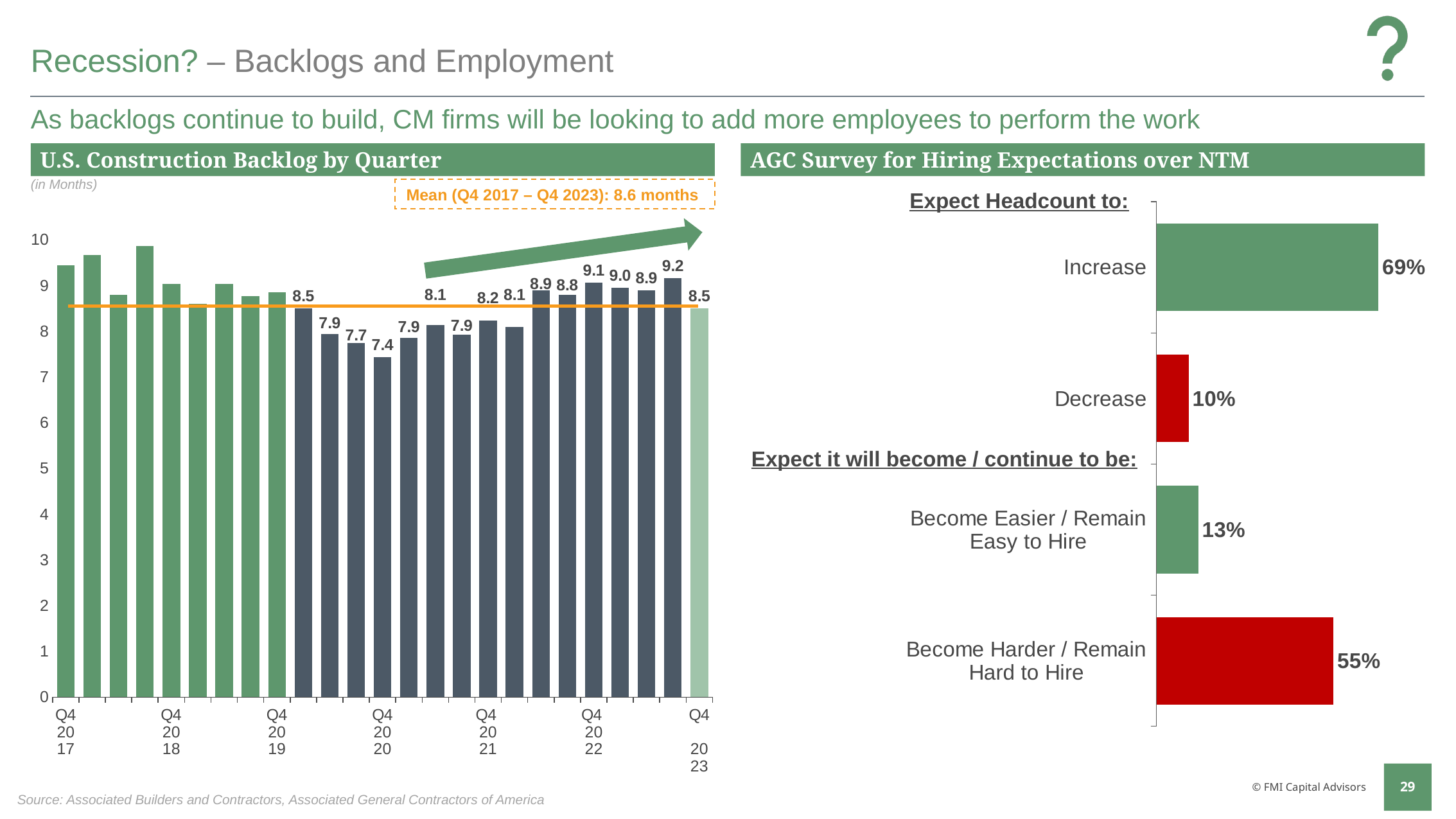
In the U.S. Construction Backlog by Quarter chart, what is the backlog value for Q4 2020? 7.4 In the AGC Survey for Hiring Expectations chart, how many percentage points higher is 'Increase' than 'Decrease'? 59% In the AGC Survey for Hiring Expectations chart, which category has the highest percentage? Increase How many categories are shown in the AGC Survey for Hiring Expectations chart? 4 In the AGC Survey for Hiring Expectations chart, which category has the lowest percentage? Decrease In the U.S. Construction Backlog by Quarter chart, what mean backlog is stated for Q4 2017 – Q4 2023? 8.6 months In the U.S. Construction Backlog by Quarter chart, what is the difference between the Q4 2022 and Q4 2023 values? 0.6 In the U.S. Construction Backlog by Quarter chart, which quarter has the lowest backlog? Q4 2020 What kind of chart is the AGC Survey for Hiring Expectations chart? Bar chart In the AGC Survey for Hiring Expectations chart, what percentage of respondents expect headcount to increase? 69% In the AGC Survey for Hiring Expectations chart, what percentage expect it will become harder / remain hard to hire? 55% In the U.S. Construction Backlog by Quarter chart, what is the backlog value for Q4 2022? 9.1